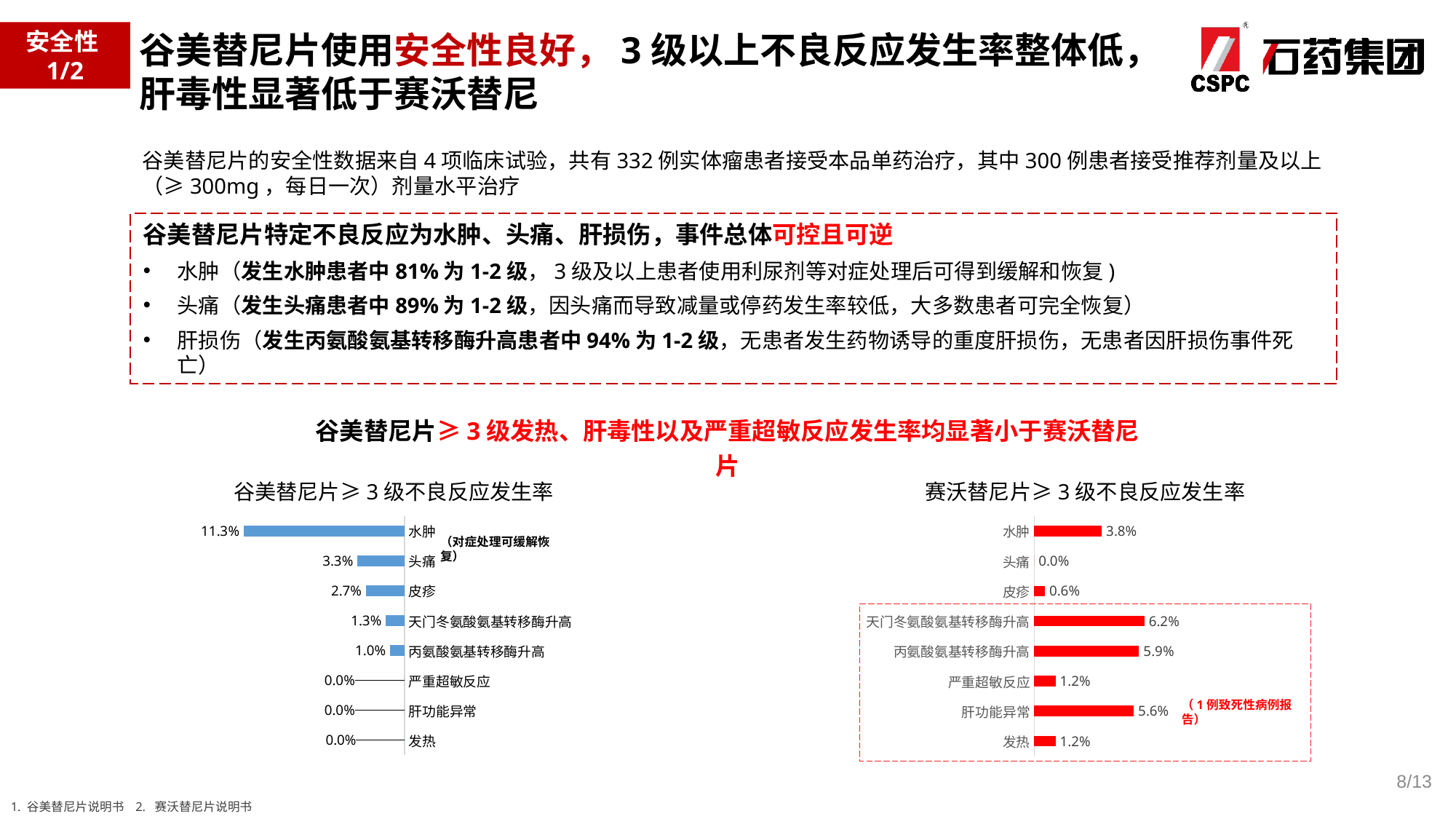
In the chart titled 赛沃替尼片≥3级不良反应发生率, which category has the lowest value? 头痛 How many categories are shown in the chart titled 谷美替尼片≥3级不良反应发生率? 8 In the chart titled 赛沃替尼片≥3级不良反应发生率, what is the value for 天门冬氨酸氨基转移酶升高? 6.2% In the chart titled 谷美替尼片≥3级不良反应发生率, what is the value for 水肿? 11.3% In the chart titled 赛沃替尼片≥3级不良反应发生率, what is the value for 肝功能异常? 5.6% In the chart titled 谷美替尼片≥3级不良反应发生率, which category has the highest value? 水肿 What type of chart is the chart titled 赛沃替尼片≥3级不良反应发生率? Bar chart In the chart titled 赛沃替尼片≥3级不良反应发生率, which category has the highest value? 天门冬氨酸氨基转移酶升高 Which is larger: the 发热 value in the 谷美替尼片 chart or the 发热 value in the 赛沃替尼片 chart? 赛沃替尼片 chart In the chart titled 谷美替尼片≥3级不良反应发生率, what is the value for 头痛? 3.3% What is the difference between the 水肿 value in the 谷美替尼片 chart (11.3%) and the 水肿 value in the 赛沃替尼片 chart (3.8%)? 7.5% In the chart titled 赛沃替尼片≥3级不良反应发生率, what is the difference between 天门冬氨酸氨基转移酶升高 and 丙氨酸氨基转移酶升高? 0.3%